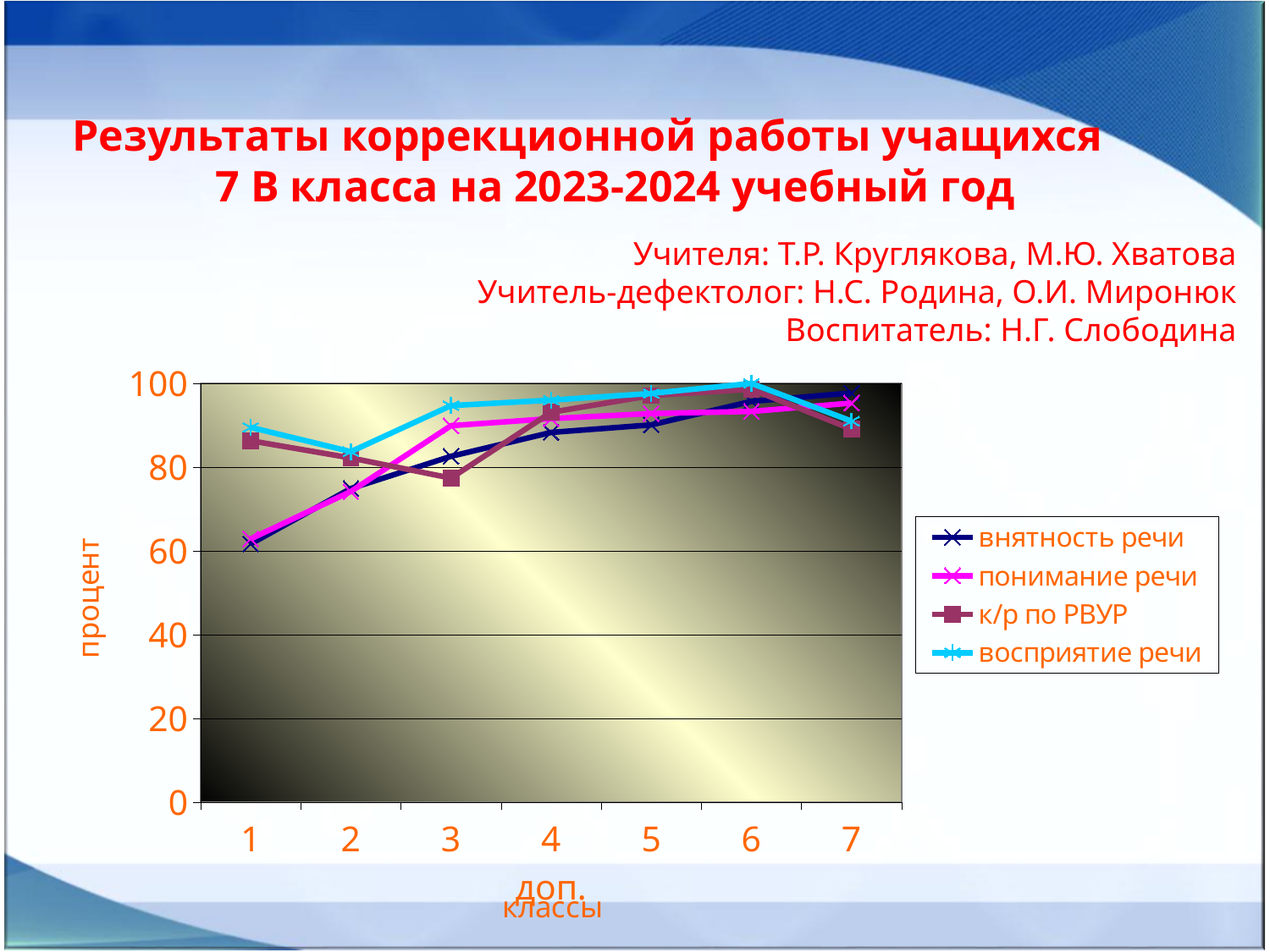
At category 3, which series has the larger value: восприятие речи or к/р по РВУР? восприятие речи At category 1, which series has the larger value: восприятие речи or внятность речи? восприятие речи Is the value for к/р по РВУР at category 1 greater or less than 80? greater What is the title of the vertical axis? процент How many series does the legend list? 4 Is the value for понимание речи at category 2 greater or less than 80? less How many categories are plotted along the x axis? 7 Is the value for внятность речи at category 1 greater or less than 80? less What kind of chart is shown on the slide? line chart Does the внятность речи series rise or fall from category 1 to category 7? rise